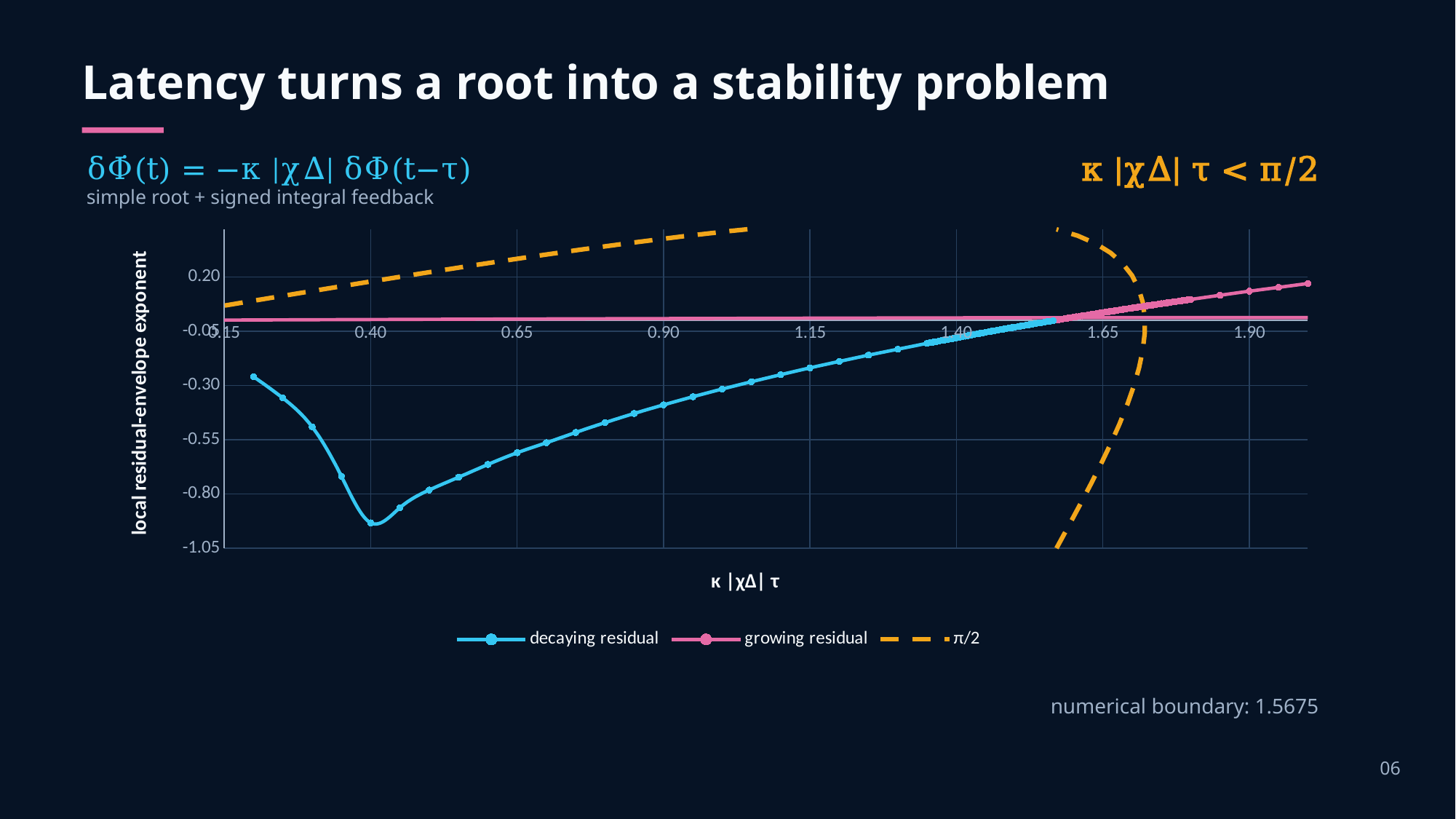
How many tick labels are shown on the chart's x axis? 8 How many series does the chart legend list? 3 Is the value of the growing residual series at x = 1.90 greater or less than 0.20? less What is the title of the chart's x axis? κ |χΔ| τ Is the value of the decaying residual series at x = 0.40 greater or less than -0.80? less Does the growing residual series rise or fall as x increases from 1.65 to 1.90? rise Does the decaying residual series rise or fall as x increases from 0.40 to 1.40? rise What are the three series named in the chart legend? decaying residual, growing residual, π/2 What kind of chart is shown on the slide? line chart At x = 0.90, which series has the higher value, decaying residual or growing residual? growing residual Is the lowest value of the decaying residual series greater or less than -0.80? less